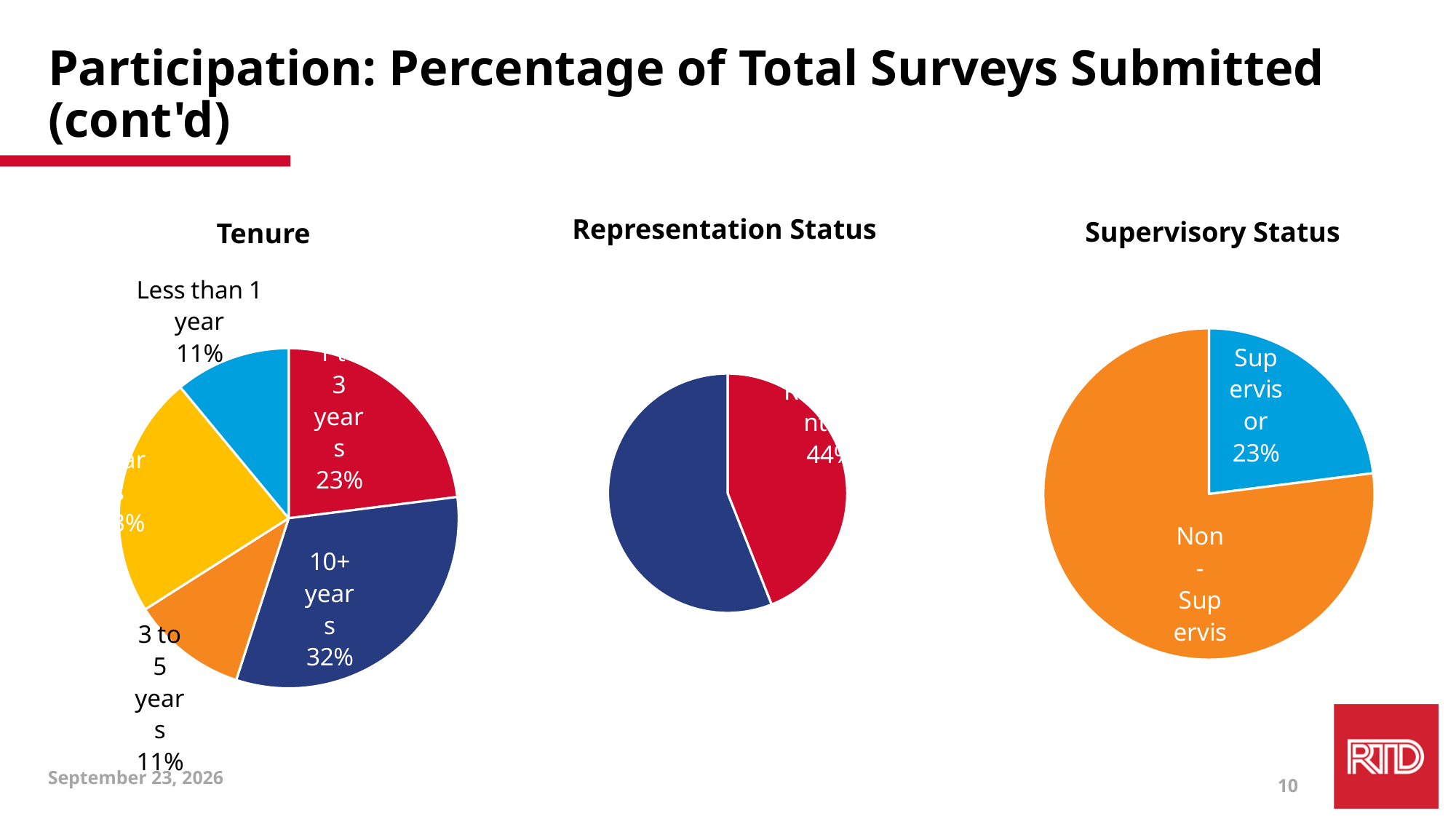
How many slices does the Representation Status pie chart have? 2 In the Tenure chart, what percentage is shown for 10+ years? 32% In the Tenure chart, which tenure category has the largest share? 10+ years In the Tenure chart, which is larger, 10+ years or 3 to 5 years? 10+ years How many slices does the Tenure pie chart have? 5 In the Tenure chart, what percentage is shown for Less than 1 year? 11% In the Supervisory Status chart, what percentage is shown for Supervisor? 23% How many charts are shown on the slide? 3 What type of chart is the Tenure chart? Pie chart In the Tenure chart, what is the difference in percentage points between 10+ years and Less than 1 year? 21 percentage points In the Tenure chart, what percentage is shown for 3 to 5 years? 11% In the Supervisory Status chart, which is larger, Supervisor or Non-Supervisor? Non-Supervisor